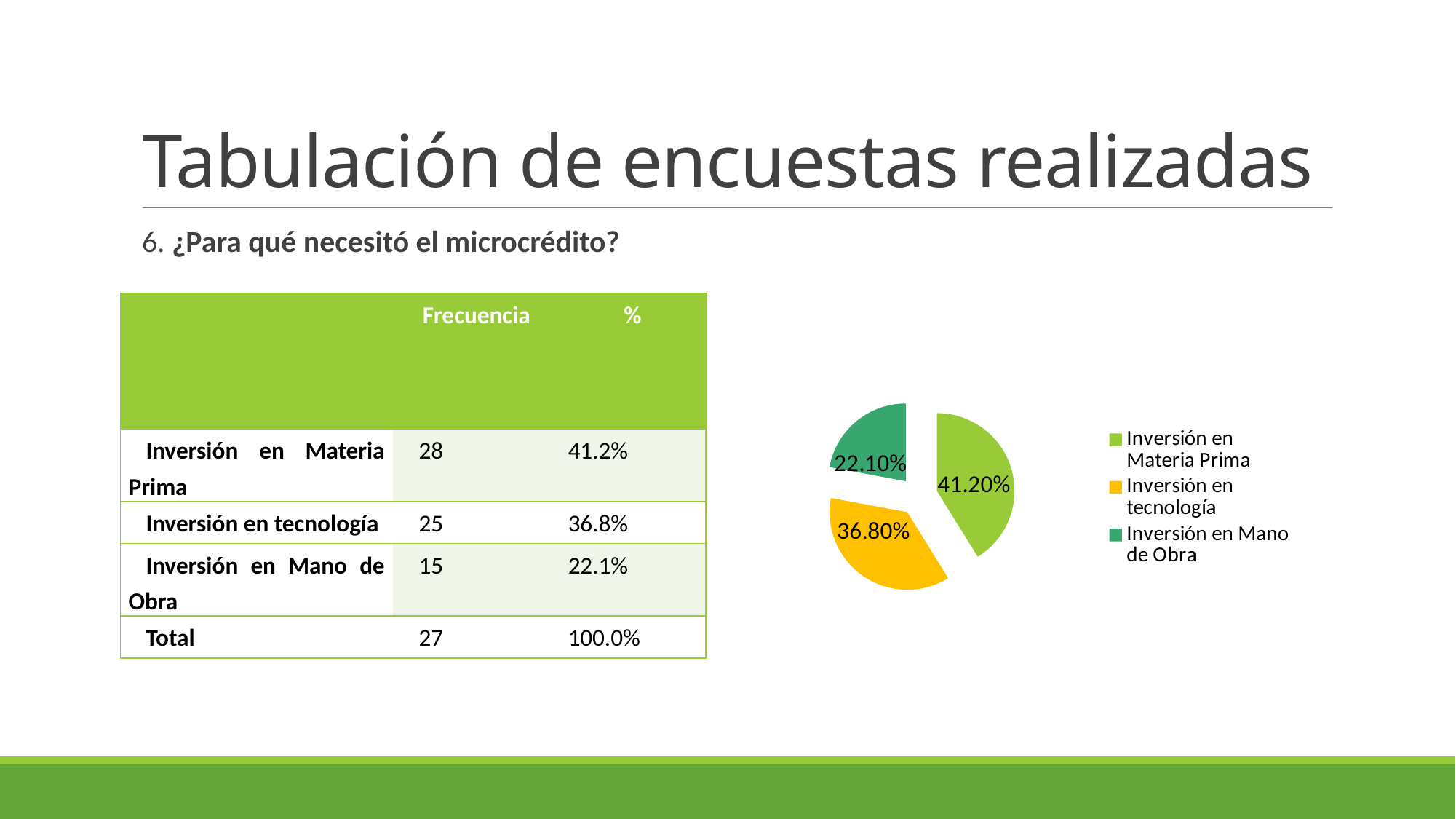
How many slices does the pie chart have? 3 Which category has the largest slice of the pie? Inversión en Materia Prima How many entries does the legend list? 3 Which is larger: the slice for Inversión en tecnología or the slice for Inversión en Mano de Obra? Inversión en tecnología What is the difference in percentage points between the Inversión en Materia Prima slice and the Inversión en Mano de Obra slice? 19.10% What colour is the slice for Inversión en tecnología? yellow What colour is the slice for Inversión en Mano de Obra? dark green What kind of chart is shown on the slide? pie chart What share of the pie does Inversión en Materia Prima have? 41.20% Which category has the smallest slice of the pie? Inversión en Mano de Obra What share of the pie does Inversión en tecnología have? 36.80% What share of the pie does Inversión en Mano de Obra have? 22.10%